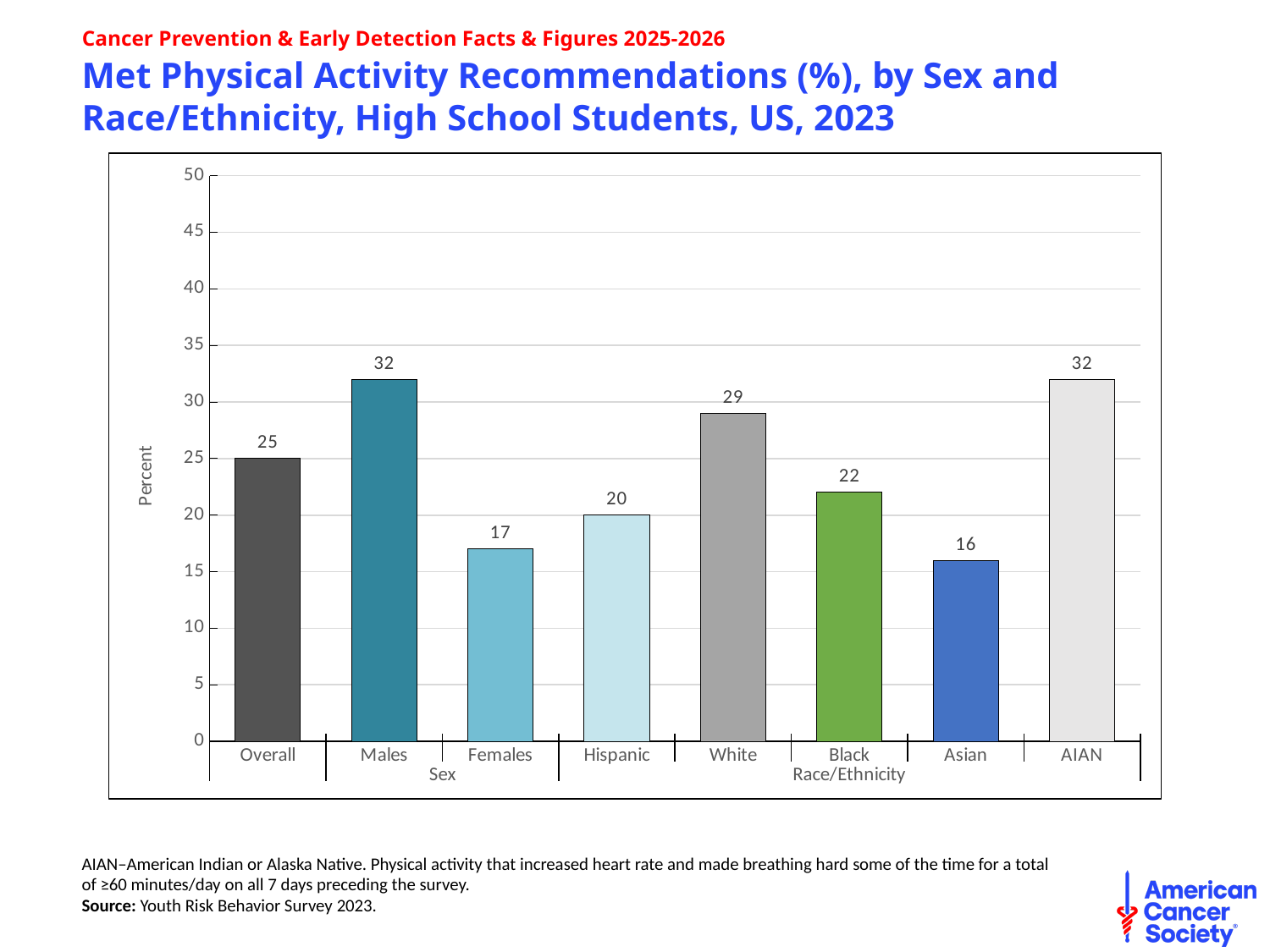
How many categories are shown on the x axis? 8 What is the value for Overall? 25 Which category has the lowest value? Asian What is the value for White? 29 What kind of chart is shown on the slide? bar chart What is the value for Females? 17 What is the difference between the values for White and Black? 7 Is the value for Asian greater or less than 20? less Which is larger, the value for Hispanic or the value for Black? Black What is the value for AIAN? 32 What is the difference between the values for Males and Females? 15 What is the label of the y axis? Percent